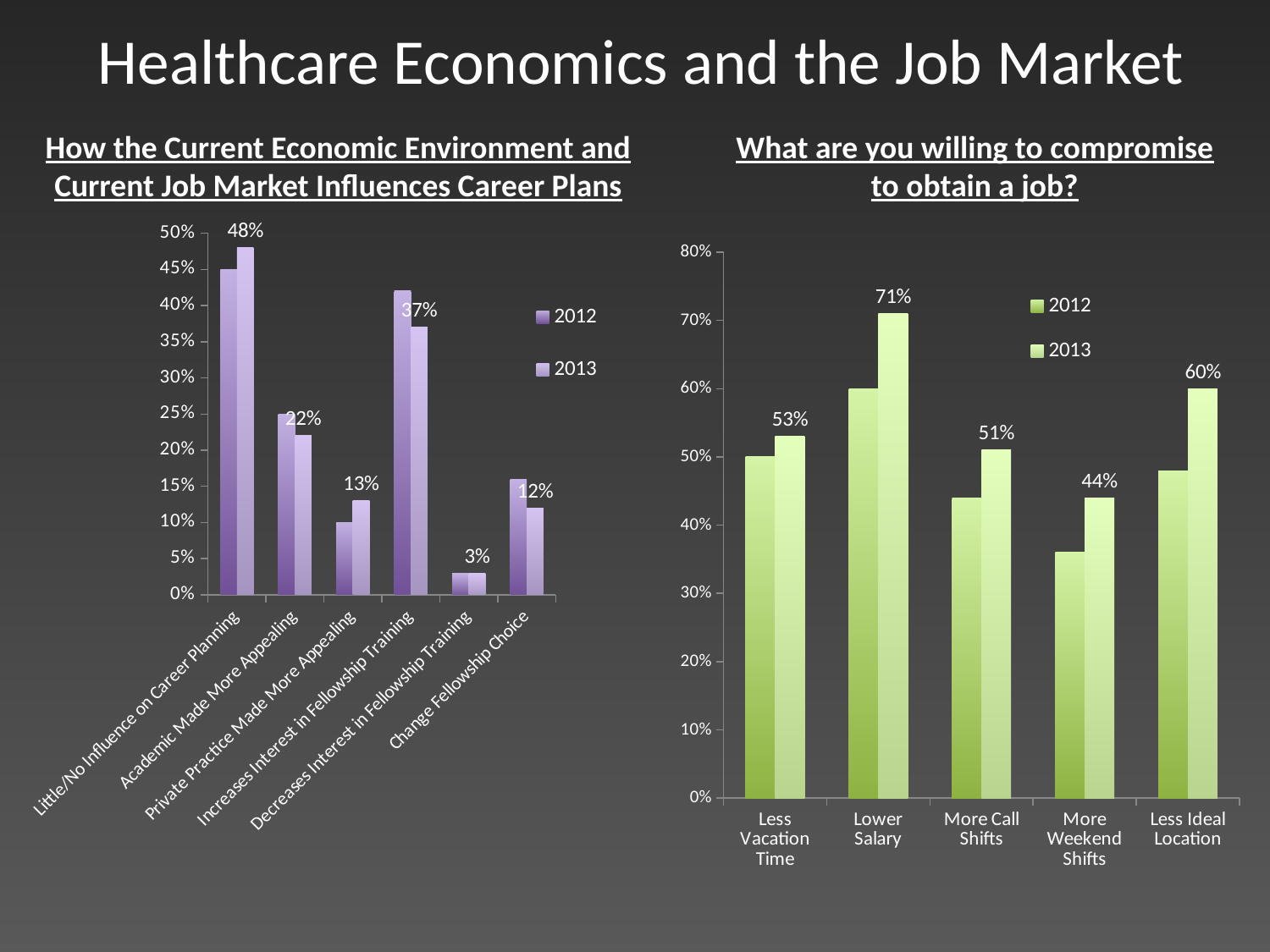
How many series does the legend list in the chart on the left? 2 In the chart 'How the Current Economic Environment and Current Job Market Influences Career Plans', what is the 2013 value for Decreases Interest in Fellowship Training? 3% In the chart 'How the Current Economic Environment and Current Job Market Influences Career Plans', what is the 2013 value for Increases Interest in Fellowship Training? 37% In the chart 'What are you willing to compromise to obtain a job?', what is the 2013 value for More Weekend Shifts? 44% In the chart 'What are you willing to compromise to obtain a job?', which category has the lowest 2013 value? More Weekend Shifts In the chart 'What are you willing to compromise to obtain a job?', is the 2012 value for More Weekend Shifts greater or less than 40%? less In the chart 'What are you willing to compromise to obtain a job?', which category has the highest 2013 value? Lower Salary In the chart 'What are you willing to compromise to obtain a job?', what is the difference between the 2013 values for Lower Salary and Less Ideal Location? 11% In the chart 'How the Current Economic Environment and Current Job Market Influences Career Plans', is the 2013 value for Academic Made More Appealing larger or smaller than the 2013 value for Private Practice Made More Appealing? larger In the chart 'What are you willing to compromise to obtain a job?', how many categories are shown on the x axis? 5 In the chart 'How the Current Economic Environment and Current Job Market Influences Career Plans', which category has the highest 2013 value? Little/No Influence on Career Planning In the chart 'What are you willing to compromise to obtain a job?', what is the 2013 value for Lower Salary? 71%